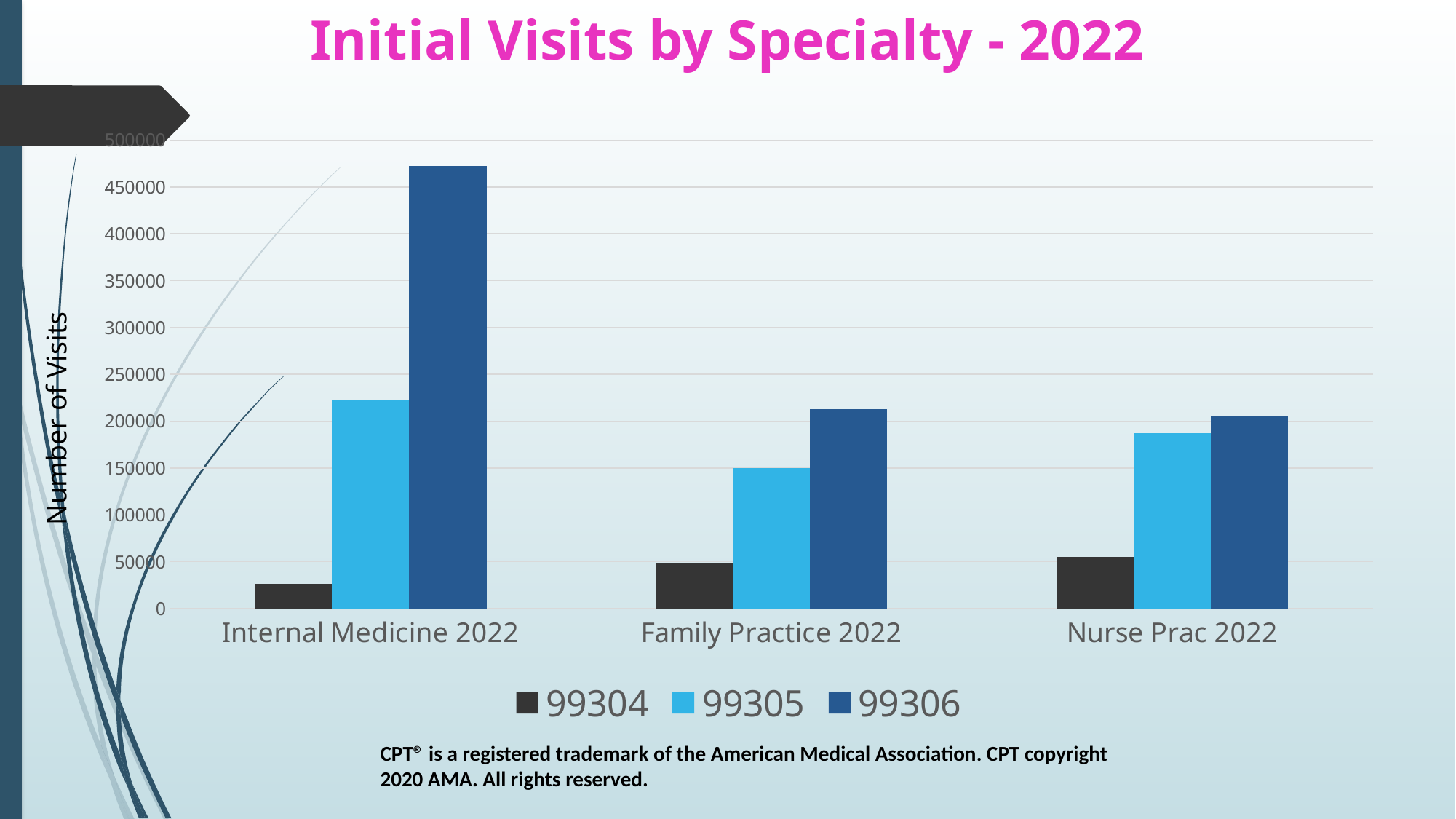
What is the label of the vertical axis? Number of Visits How many specialty categories are shown on the x axis? 3 Is the value for 99305 in Internal Medicine 2022 greater or less than 200000? greater Is the value for 99304 in Internal Medicine 2022 greater or less than 50000? less How many series does the legend list? 3 Which specialty has the lowest value for 99304? Internal Medicine 2022 Which specialty has the highest value for 99306? Internal Medicine 2022 What type of chart is shown on the slide? bar chart Is the value for 99306 in Internal Medicine 2022 greater or less than 450000? greater Which is larger for Nurse Prac 2022: the value for 99305 or the value for 99306? 99306 What is the title of the chart? Initial Visits by Specialty - 2022